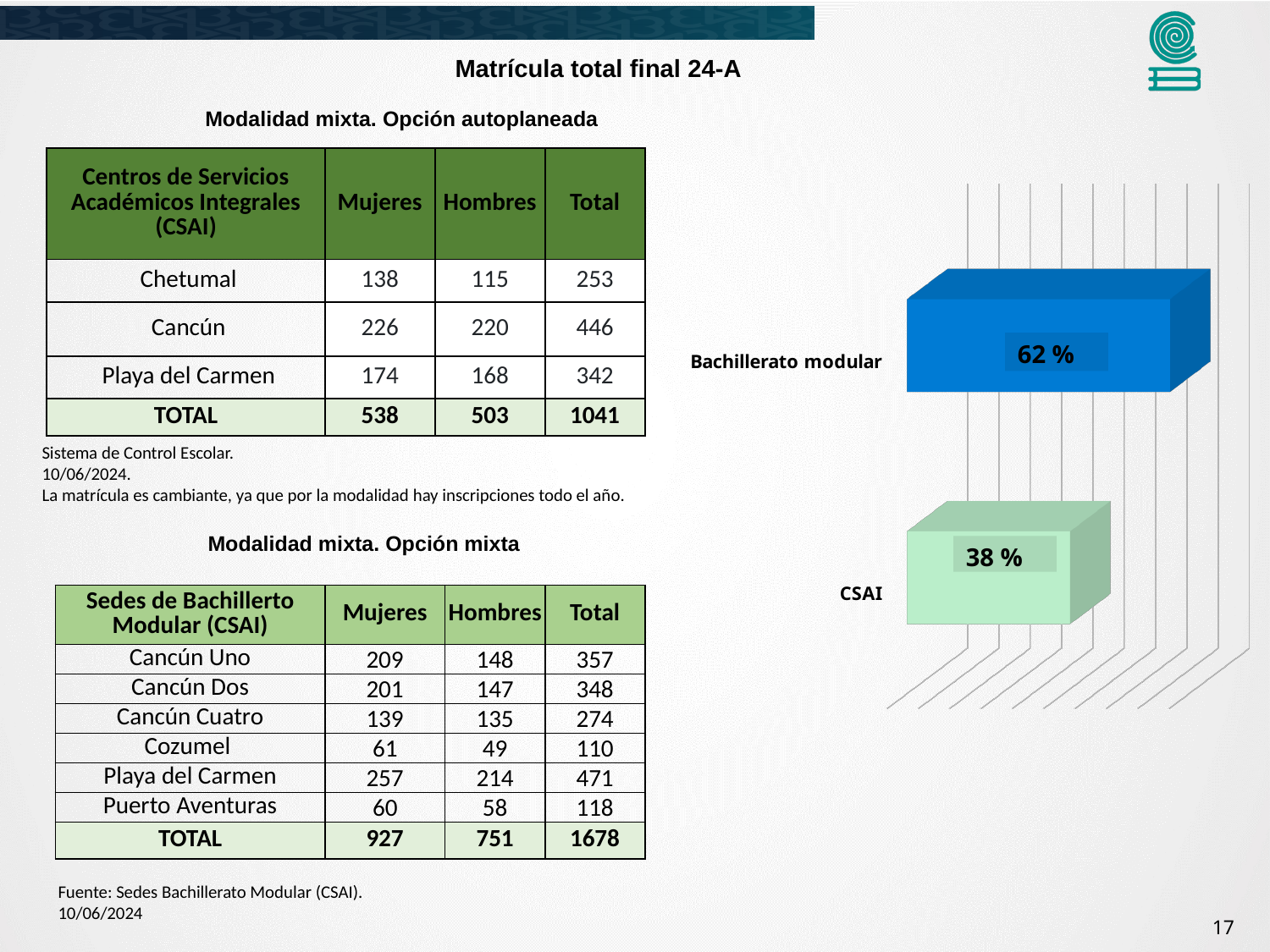
What is the difference between the values for Bachillerato modular and CSAI in the bar chart? 24 % In the bar chart, which is larger: the value for Bachillerato modular or the value for CSAI? Bachillerato modular What colour is the bar for Bachillerato modular in the bar chart? blue What is the value shown for CSAI in the bar chart? 38 % What is the total of the two values shown in the bar chart? 100 % Which category has the lowest value in the bar chart? CSAI What is the value shown for Bachillerato modular in the bar chart? 62 % What kind of chart is shown on the right side of the slide? bar chart How many categories does the bar chart show? 2 What colour is the bar for CSAI in the bar chart? light green Which category has the highest value in the bar chart? Bachillerato modular